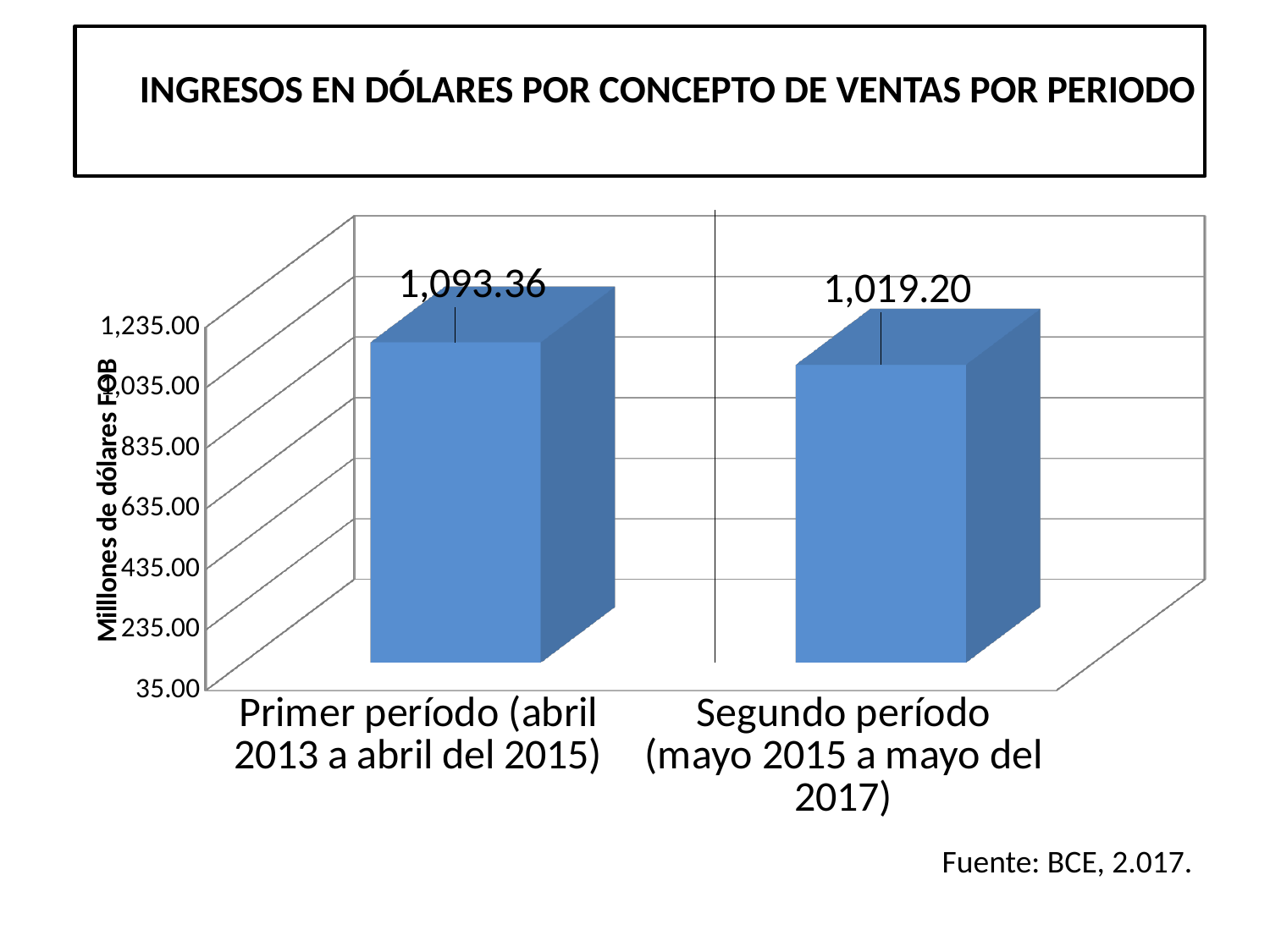
Is the value for Primer período greater or less than 1,035.00? greater How many categories are shown in the chart? 2 What kind of chart is shown on the slide? bar chart Which period has the lowest value? Segundo período (mayo 2015 a mayo del 2017) What is the value for Segundo período (mayo 2015 a mayo del 2017)? 1,019.20 Is the value for Segundo período greater or less than 1,035.00? less Do the values rise or fall from the first period to the second period? fall Which period has the highest value? Primer período (abril 2013 a abril del 2015) What is the value for Primer período (abril 2013 a abril del 2015)? 1,093.36 Which is larger, the value for Primer período or the value for Segundo período? Primer período What is the difference between the value for Primer período and the value for Segundo período? 74.16 What is the title of the chart? INGRESOS EN DÓLARES POR CONCEPTO DE VENTAS POR PERIODO